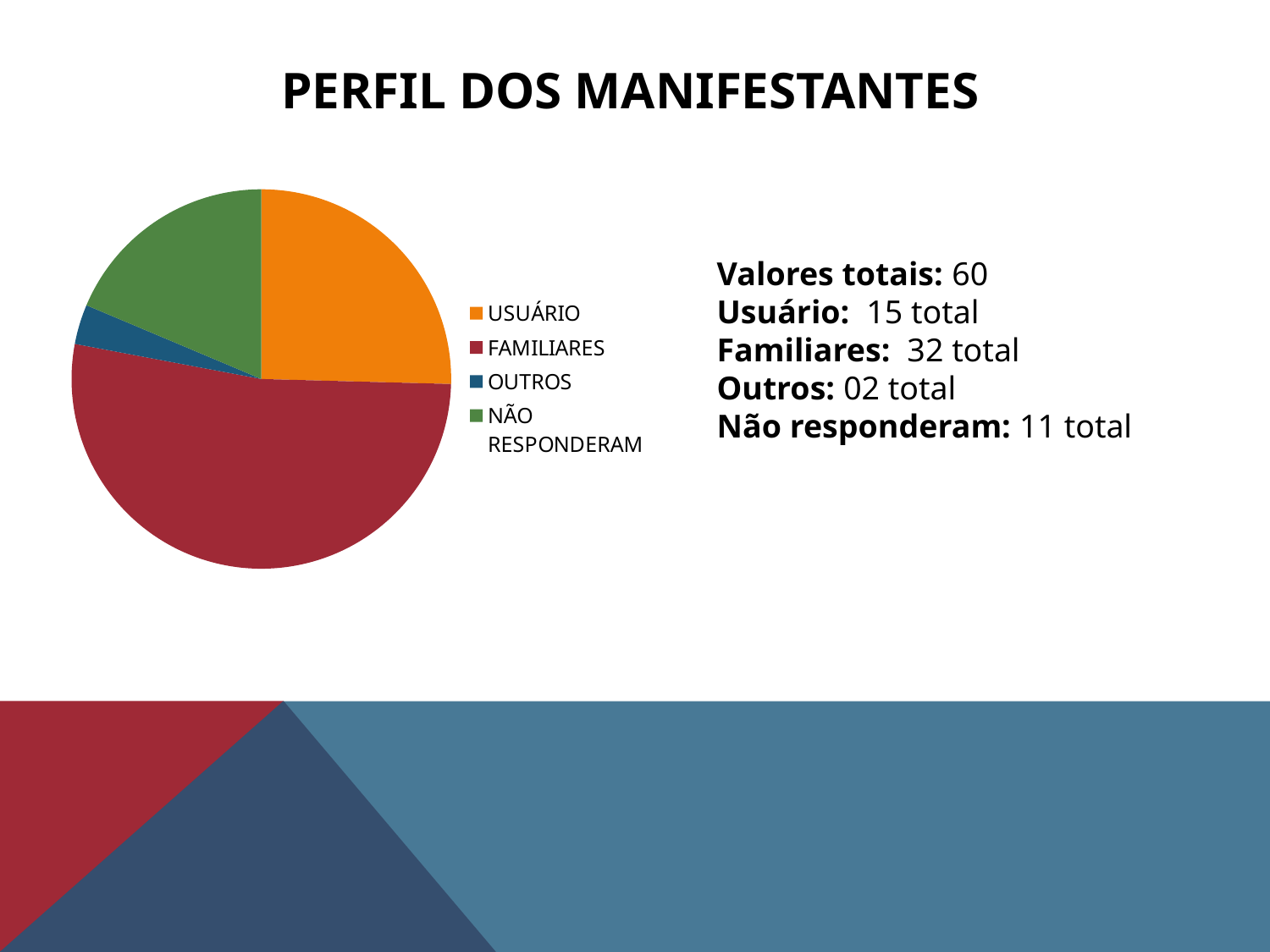
What is the value for Familiares? 32 Which is larger, the value for Usuário or the value for Não responderam? Usuário Which category has the smallest slice of the pie? OUTROS How many categories does the pie chart's legend list? 4 What is the difference between the Familiares value and the Usuário value? 17 What is the value for Outros? 02 What kind of chart is shown on the slide? pie chart Which category has the largest slice of the pie? FAMILIARES What is the value for Usuário? 15 What colour is the FAMILIARES slice in the pie chart? red What is the value for Não responderam? 11 What share of the total does the Usuário slice represent? 25%